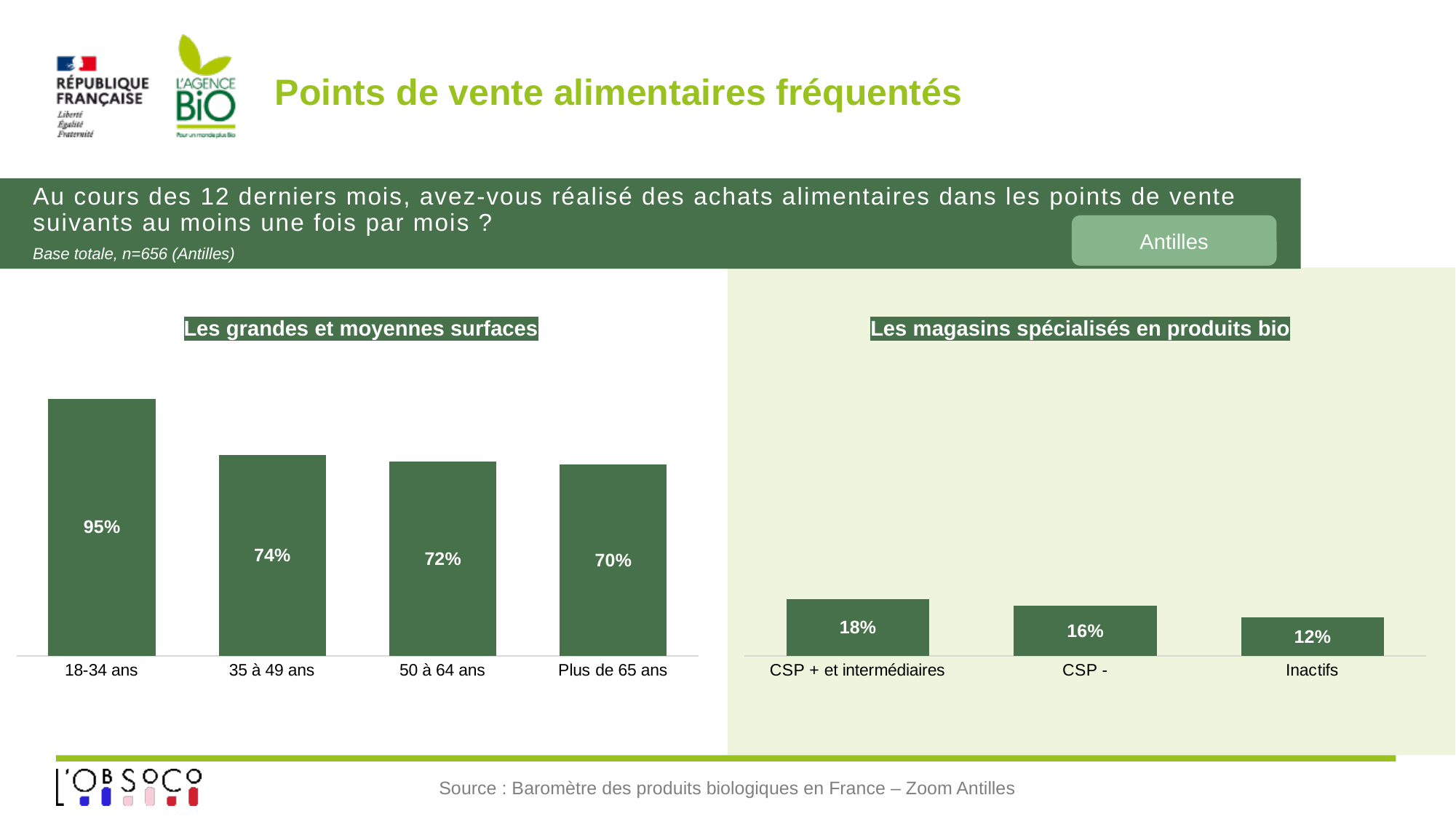
In the chart 'Les grandes et moyennes surfaces', do the values rise or fall from left to right across the age groups? Fall In the chart 'Les magasins spécialisés en produits bio', what is the value for CSP -? 16% In the chart 'Les grandes et moyennes surfaces', which is larger: the value for 35 à 49 ans or the value for Plus de 65 ans? 35 à 49 ans In the chart 'Les magasins spécialisés en produits bio', what is the difference between the values for CSP + et intermédiaires and Inactifs? 6% In the chart 'Les grandes et moyennes surfaces', what is the difference between the values for 18-34 ans and 35 à 49 ans? 21% In the chart 'Les grandes et moyennes surfaces', which age group has the highest value? 18-34 ans What kind of chart is 'Les grandes et moyennes surfaces'? Bar chart How many categories are shown in the chart 'Les magasins spécialisés en produits bio'? 3 In the chart 'Les magasins spécialisés en produits bio', which category has the lowest value? Inactifs In the chart 'Les magasins spécialisés en produits bio', what is the value for Inactifs? 12% In the chart 'Les grandes et moyennes surfaces', what is the value for 18-34 ans? 95% In the chart 'Les grandes et moyennes surfaces', what is the value for Plus de 65 ans? 70%